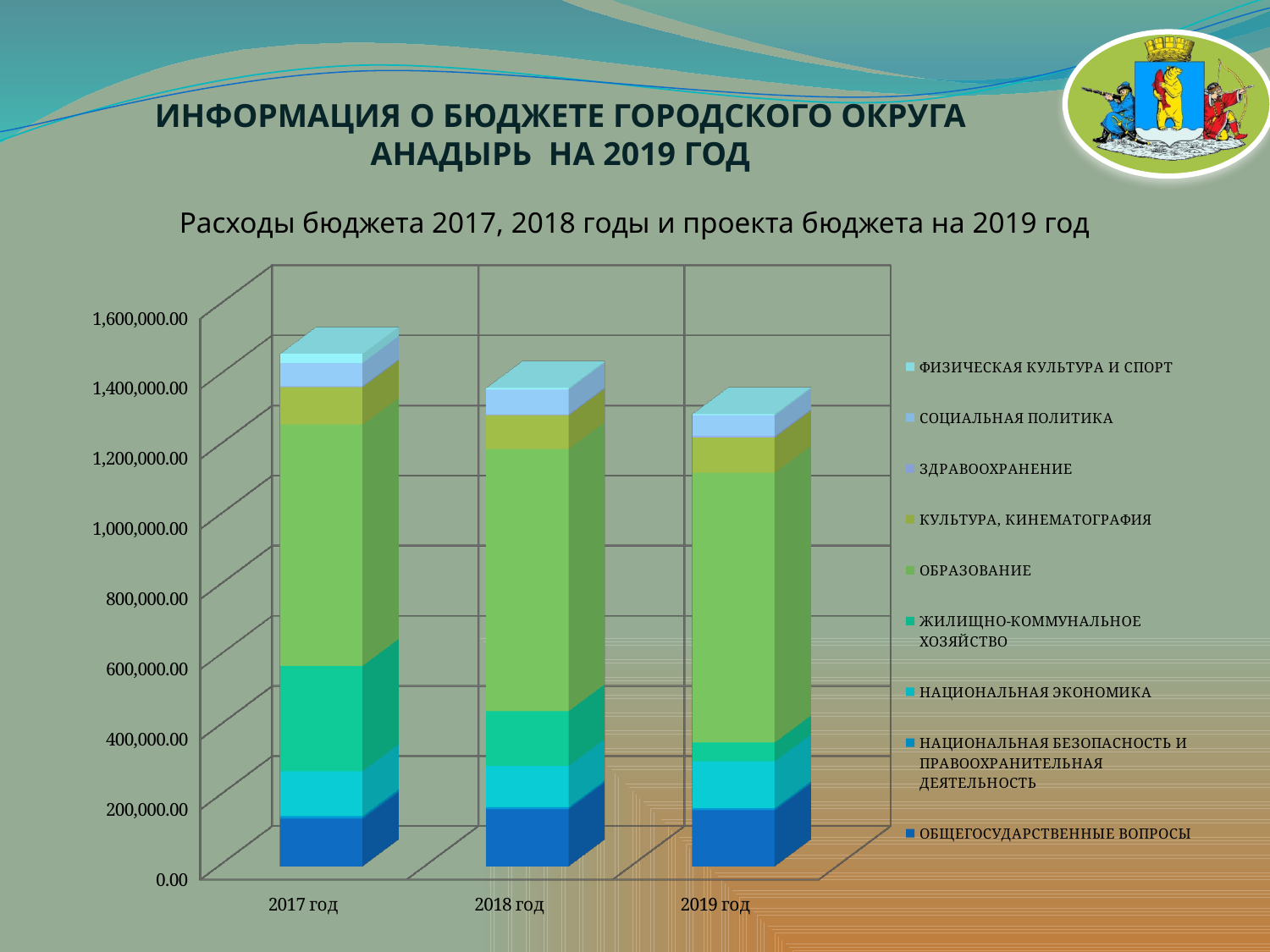
Which year has the highest total budget expenditure in the chart? 2017 год Which year has the lowest total budget expenditure in the chart? 2019 год Is the total value for 2019 год greater or less than 1,200,000.00? greater What kind of chart is shown on the slide? Stacked bar chart Is the total value for 2019 год greater or less than 1,400,000.00? less What is the title of the chart? Расходы бюджета 2017, 2018 годы и проекта бюджета на 2019 год Which legend series occupies the largest segment of each stacked bar? ОБРАЗОВАНИЕ Do the total expenditures rise or fall from 2017 to 2019? Fall How many series does the chart legend list? 9 Which is larger, the total bar for 2017 год or for 2019 год? 2017 год Is the total value for 2017 год greater or less than 1,400,000.00? greater How many years (categories) are shown on the x axis of the chart? 3